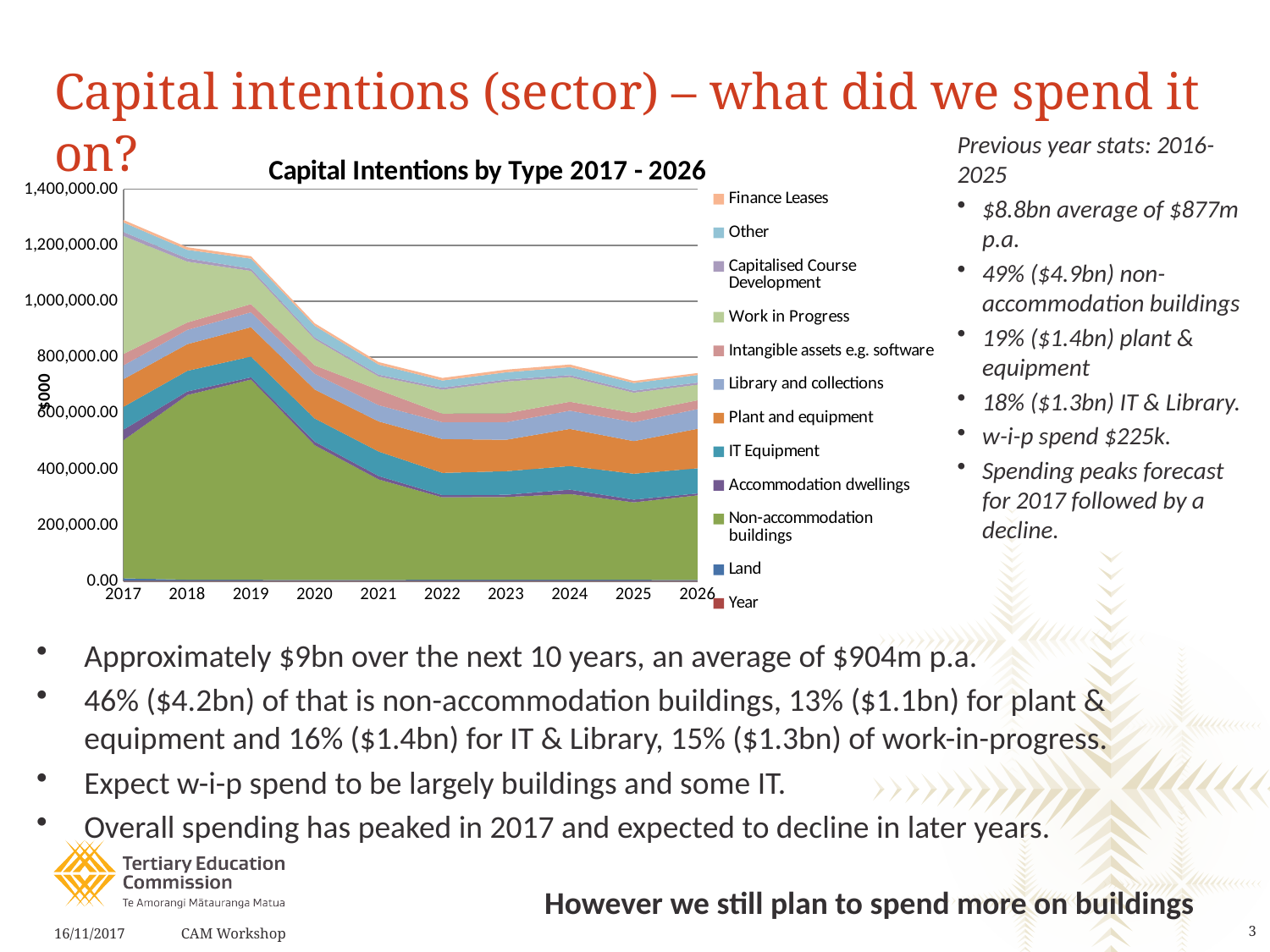
Is the total capital intentions value for 2017 greater or less than 1,200,000.00? greater Which year has the larger total capital intentions, 2017 or 2026? 2017 Which year has the highest total capital intentions in the chart? 2017 What is the label on the chart's y axis? $000 Is the total capital intentions value for 2026 greater or less than 800,000.00? less What is the title of the chart? Capital Intentions by Type 2017 - 2026 What kind of chart is shown on the slide? Stacked area chart How many entries does the chart's legend list? 12 Is the total capital intentions value for 2019 greater or less than 1,000,000.00? greater Which year has the larger total capital intentions, 2018 or 2021? 2018 How many years are plotted along the x axis of the chart? 10 Does the total capital intentions value fall or rise from 2017 to 2026? Fall